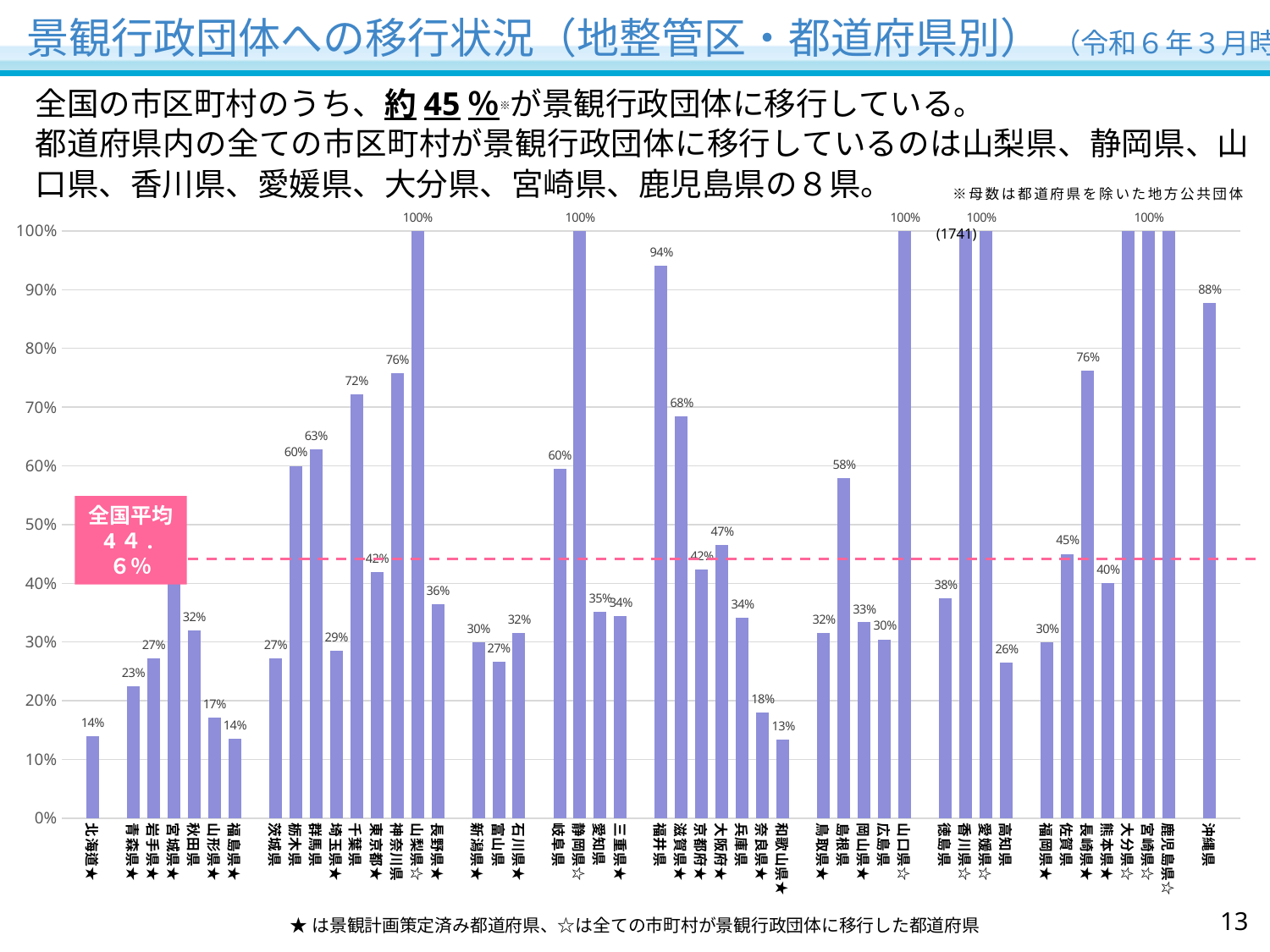
What kind of chart is this? bar chart How many prefectures are shown on the x axis? 47 What is the value for 北海道★? 14% What is the value for 神奈川県? 76% How many prefectures have a value of 100%? 8 What national average (全国平均) is marked by the dashed line? 44.6% Is the value for 島根県 greater or less than 50%? greater What is the value for 福井県? 94% Which prefecture has the lowest value? 和歌山県★ What is the value for 沖縄県? 88% What is the difference between 群馬県 and 栃木県? 3 percentage points